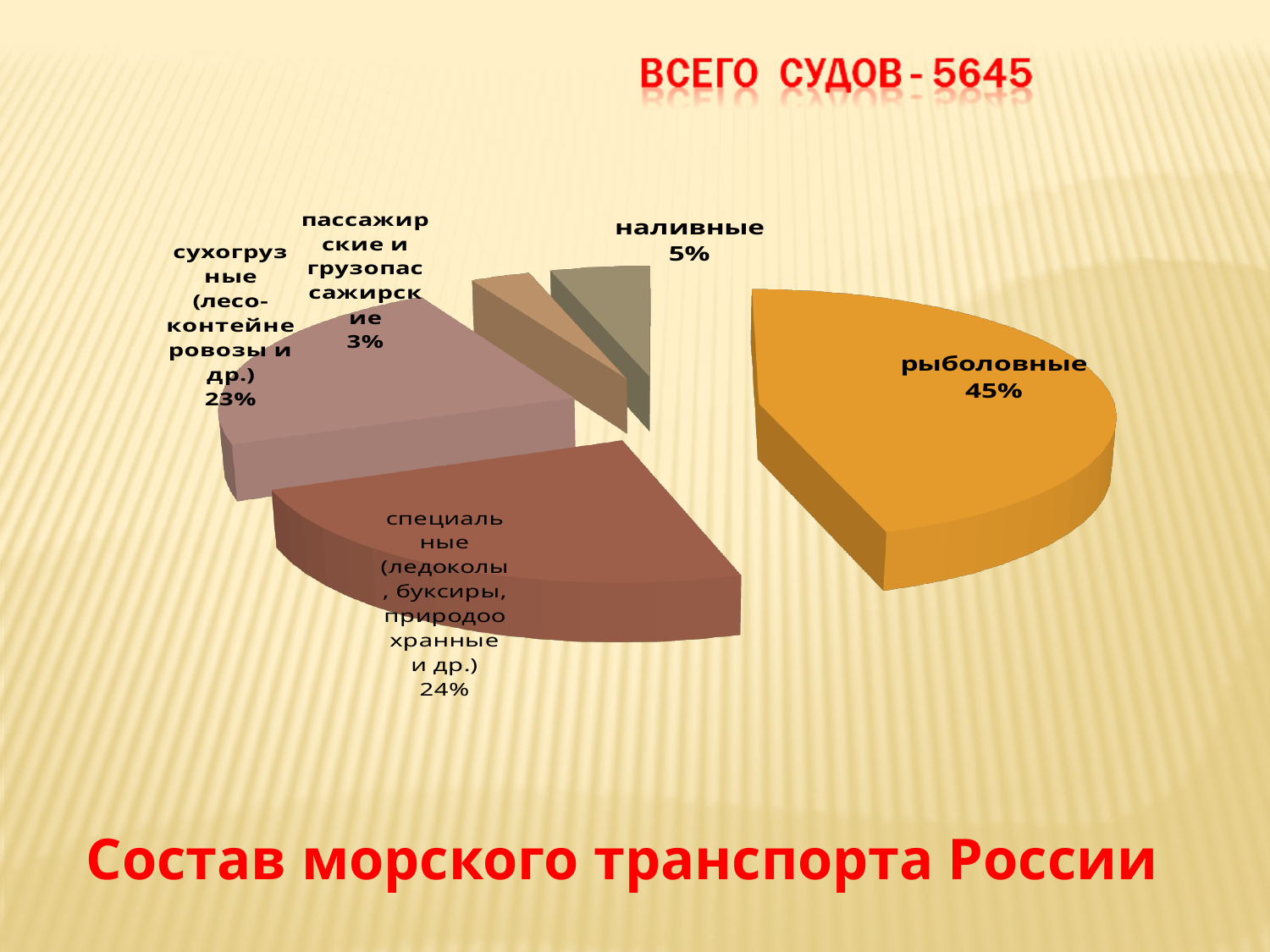
What share of the pie is labelled рыболовные? 45% What type of chart is shown on the slide? pie chart How many slices does the pie chart have? 5 What is the difference in percentage points between the рыболовные slice and the специальные slice? 21 Which category has the largest slice of the pie? рыболовные What share of the pie is labelled сухогрузные (лесо-контейнеровозы и др.)? 23% What share of the pie is labelled пассажирские и грузопассажирские? 3% Which slice is larger, наливные or пассажирские и грузопассажирские? наливные What share of the pie is labelled специальные (ледоколы, буксиры, природоохранные и др.)? 24% Which category has the smallest slice of the pie? пассажирские и грузопассажирские What share of the pie is labelled наливные? 5% According to the text at the top of the slide, what is the total number of vessels (всего судов)? 5645